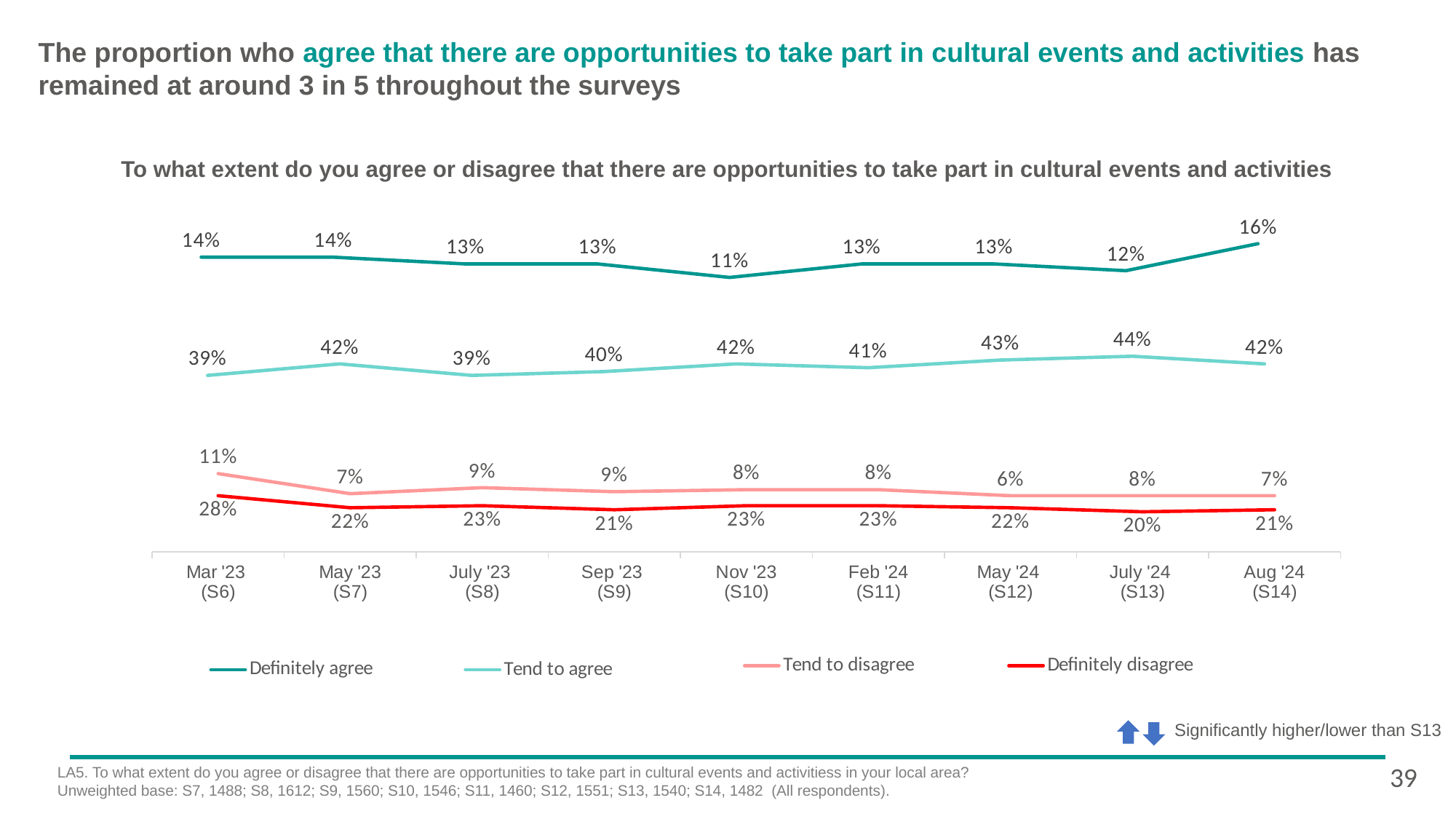
Which is larger for Tend to agree: Mar '23 (S6) or May '23 (S7)? May '23 (S7) What is the value for Tend to agree in Nov '23 (S10)? 42% How many survey waves are plotted along the x axis? 9 What is the value for Definitely agree in Aug '24 (S14)? 16% What kind of chart is shown on the slide? Line chart In which survey wave is Tend to agree highest? July '24 (S13) In which survey wave is Definitely agree lowest? Nov '23 (S10) In which survey wave is Definitely agree highest? Aug '24 (S14) What is the value for Tend to agree in July '24 (S13)? 44% By how many percentage points did Definitely agree change from July '24 (S13) to Aug '24 (S14)? 4 percentage points How many series does the legend list? 4 What colour is the Definitely disagree line in the legend? Red